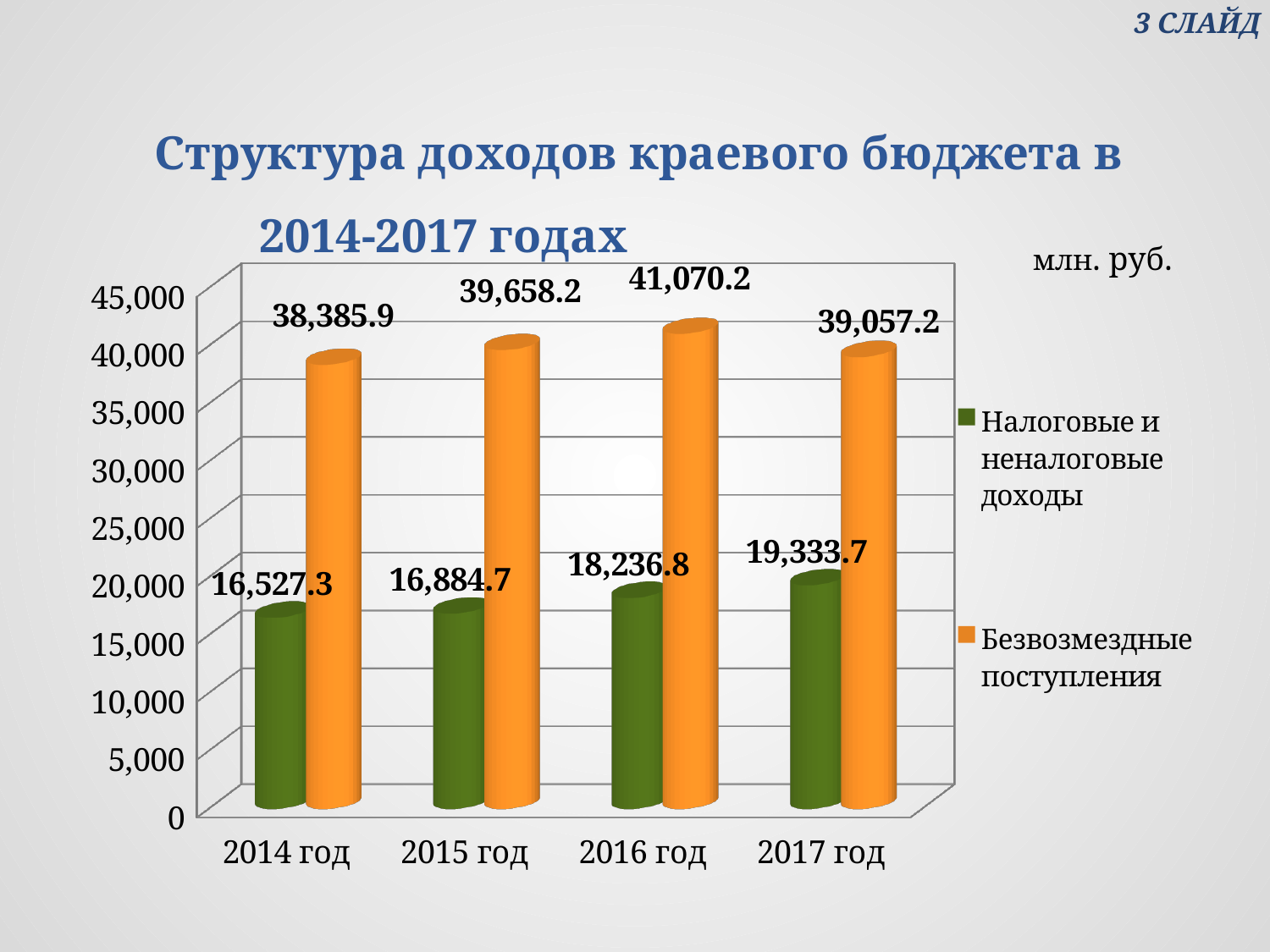
In which year is Налоговые и неналоговые доходы lowest? 2014 год How many series does the legend list? 2 What kind of chart is shown on the slide? Bar chart In which year is Безвозмездные поступления highest? 2016 год What is the difference between Безвозмездные поступления in 2016 год and 2015 год? 1,412.0 What is the value for Налоговые и неналоговые доходы in 2014 год? 16,527.3 Do the values for Налоговые и неналоговые доходы rise or fall from 2014 год to 2017 год? Rise How many years are shown on the x axis? 4 What is the value for Безвозмездные поступления in 2017 год? 39,057.2 What is the value for Безвозмездные поступления in 2016 год? 41,070.2 What is the difference between Налоговые и неналоговые доходы in 2017 год and 2014 год? 2,806.4 Which is larger in 2015 год: Налоговые и неналоговые доходы or Безвозмездные поступления? Безвозмездные поступления